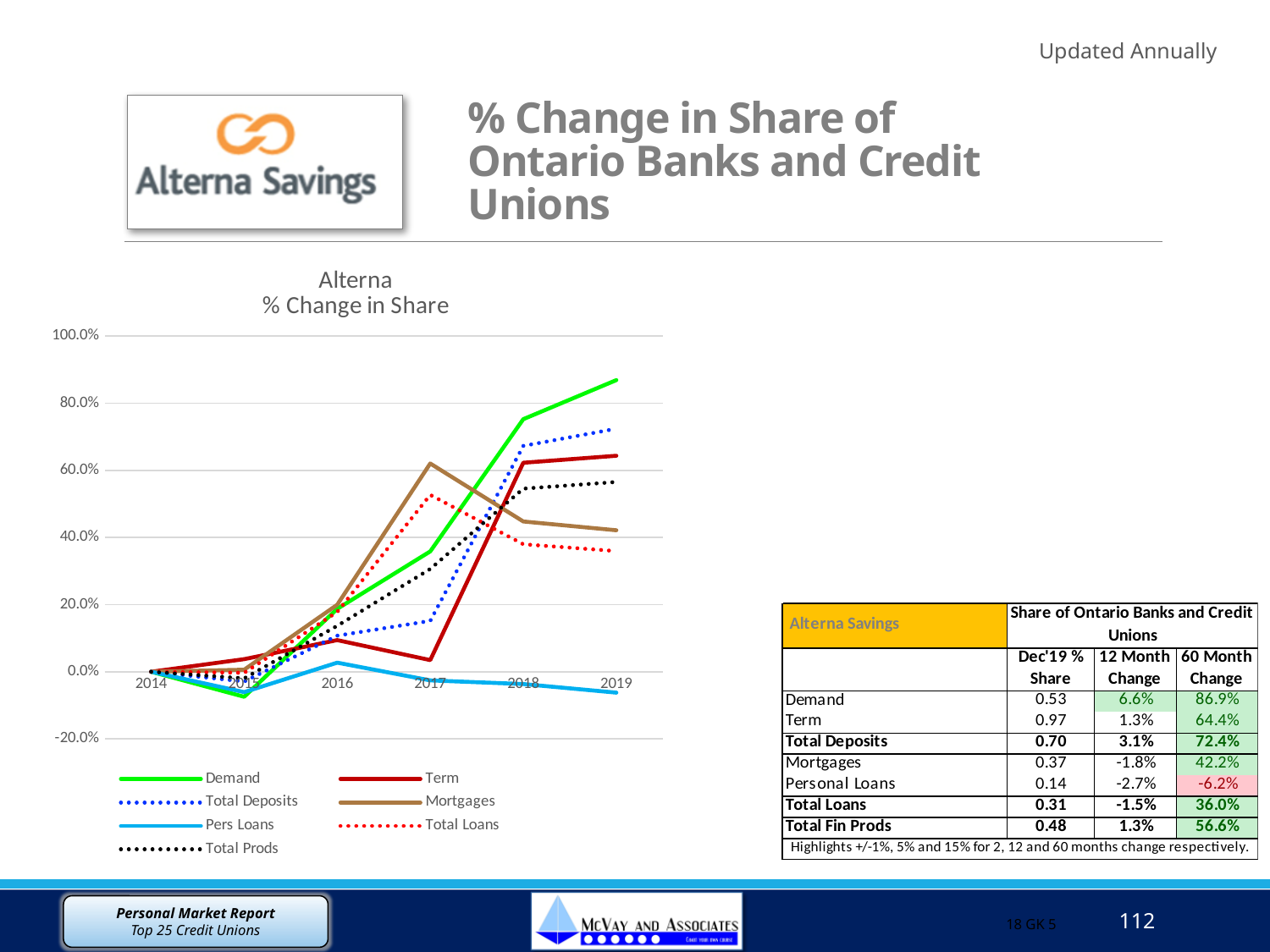
Is the value for Pers Loans in 2019 greater or less than 0.0%? less Is the value for Mortgages in 2017 greater or less than 40.0%? greater Which series has the highest value in 2019? Demand How many years are shown along the x axis of the chart? 6 How many series does the chart legend list? 7 What is the title of the chart? Alterna % Change in Share Does the Demand line rise or fall from 2016 to 2019? rise In 2017, which is larger: the value for Mortgages or the value for Demand? Mortgages What kind of chart is shown on the slide? line chart Is the value for Demand in 2019 greater or less than 80.0%? greater Which series has the lowest value in 2019? Pers Loans